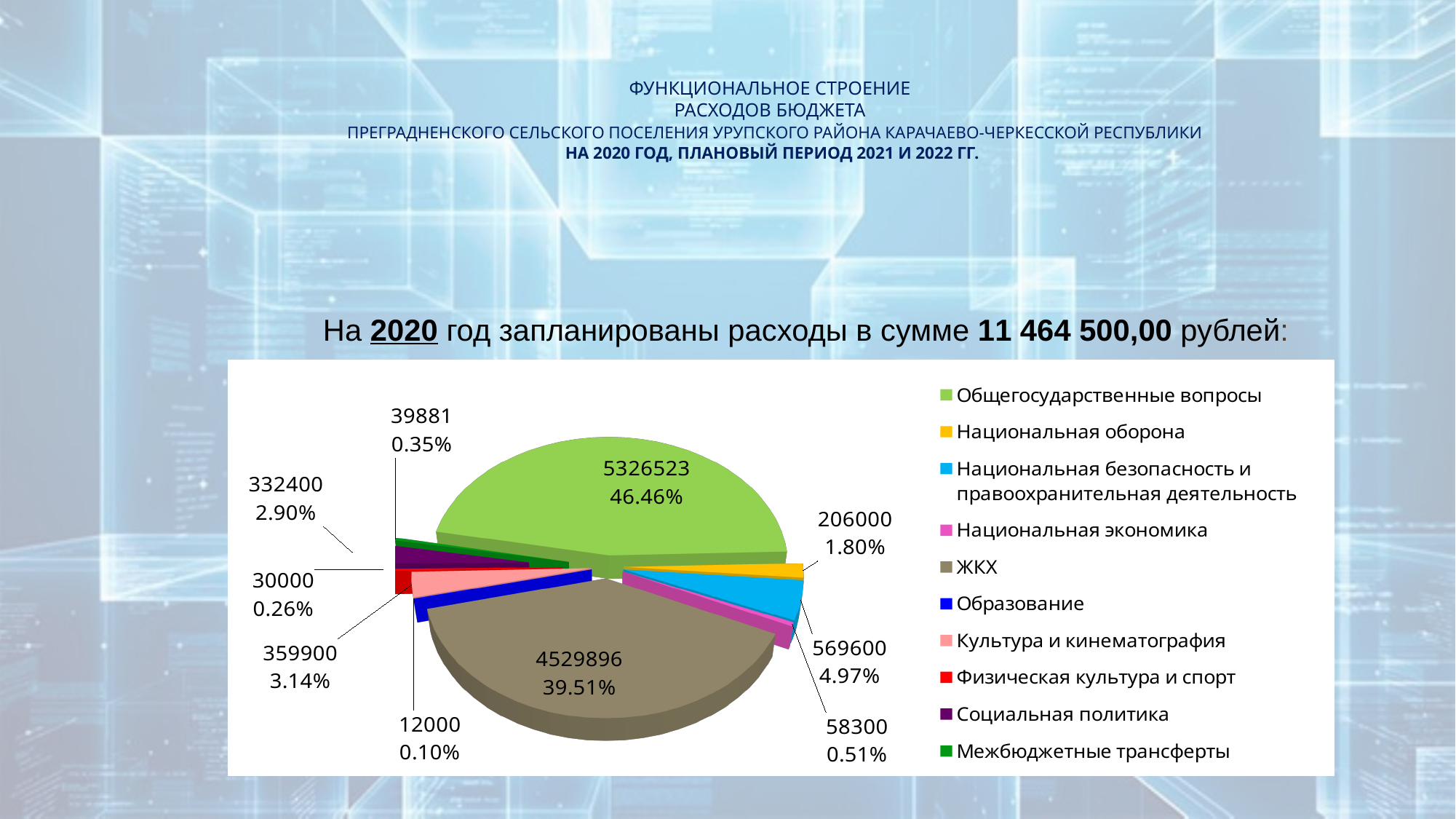
What value is shown for Национальная безопасность и правоохранительная деятельность? 569600 What share of the pie does ЖКХ represent? 39.51% Which category has the largest slice of the pie? Общегосударственные вопросы What value is shown for Общегосударственные вопросы? 5326523 Which category has the smallest slice of the pie? Образование Which is larger, the value for Культура и кинематография or the value for Социальная политика? Культура и кинематография What is the difference between the values for Общегосударственные вопросы and ЖКХ? 796627 What percentage is shown for Национальная оборона? 1.80% How many categories does the legend of the pie chart list? 10 What kind of chart is shown on the slide? pie chart What total planned expenditure for 2020 is stated above the chart? 11 464 500,00 рублей What value is shown for Межбюджетные трансферты? 39881